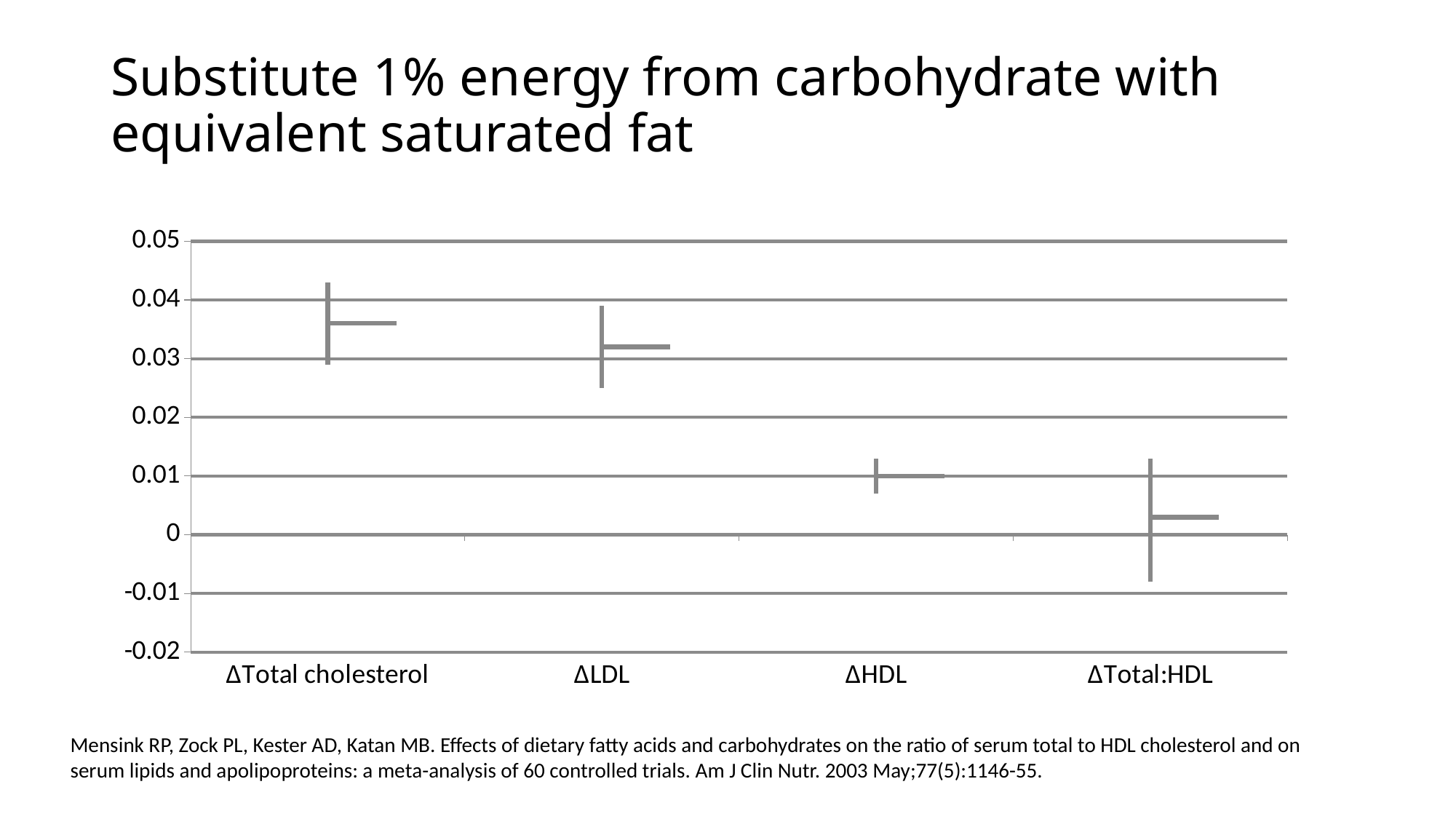
What is the title of the slide containing the chart? Substitute 1% energy from carbohydrate with equivalent saturated fat Is the value for ΔTotal:HDL greater or less than 0.01? less Is the value for ΔLDL greater or less than 0.02? greater Do the plotted values rise or fall moving from left to right along the x axis? fall Is the value for ΔTotal cholesterol greater or less than 0.03? greater Which category has the lowest plotted value? ΔTotal:HDL Which category has the highest plotted value? ΔTotal cholesterol How many categories are plotted on the x axis of the chart? 4 Which is larger, the value for ΔTotal cholesterol or the value for ΔHDL? ΔTotal cholesterol What is the lowest value shown on the chart's y axis? -0.02